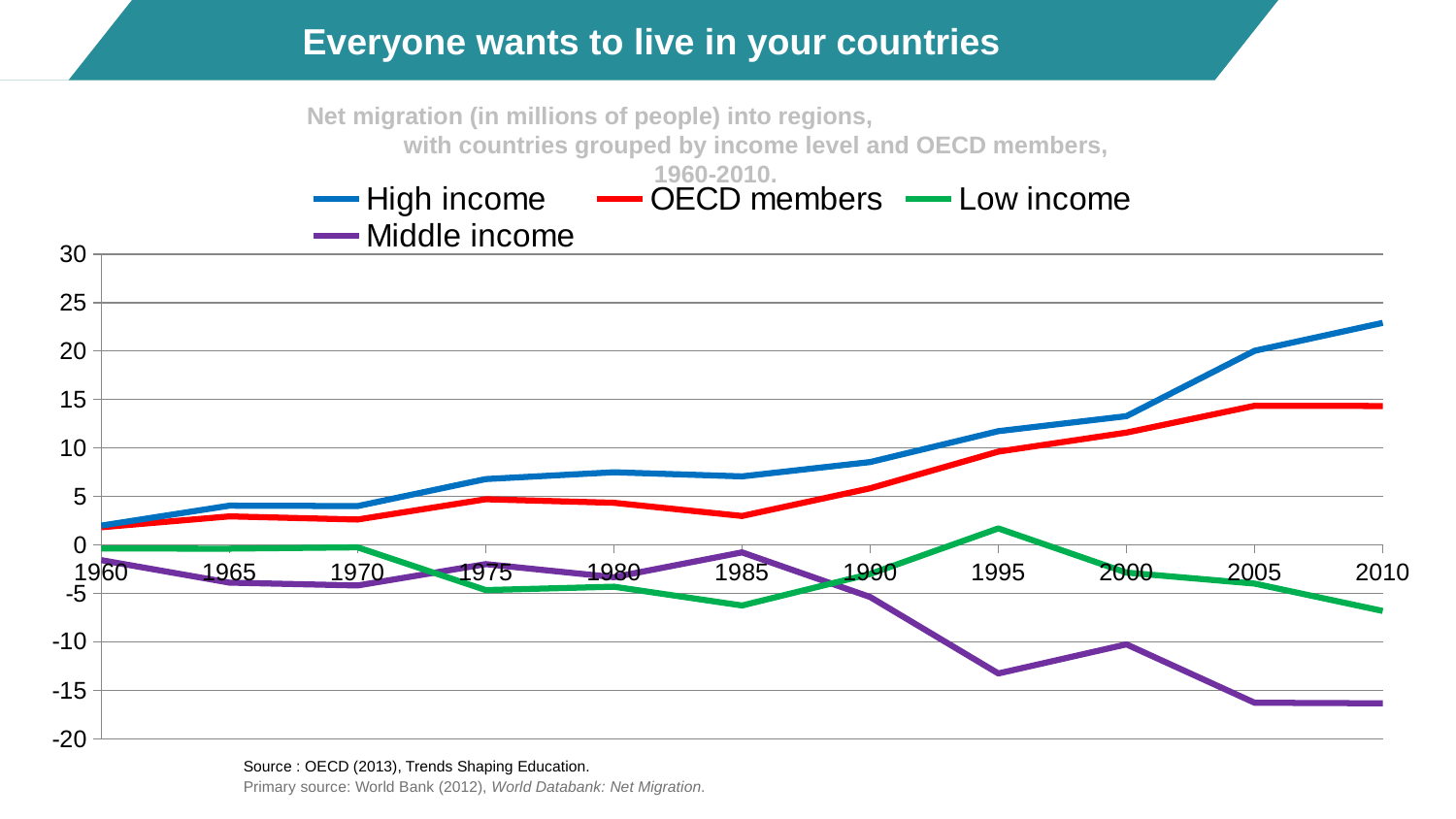
Does the High income line generally rise or fall from 1960 to 2010? rise In 2010, which is larger: the value for High income or the value for OECD members? High income Is the value for Middle income in 2000 greater or less than -5? less Which series has the highest value in 2010? High income What kind of chart is shown on the slide? line chart Which series has the lowest value in 2010? Middle income How many series does the legend list? 4 How many years are marked along the x axis? 11 Is the value for Middle income in 2005 greater or less than -15? less Is the value for OECD members in 1985 greater or less than 5? less What colour is the Low income line? green